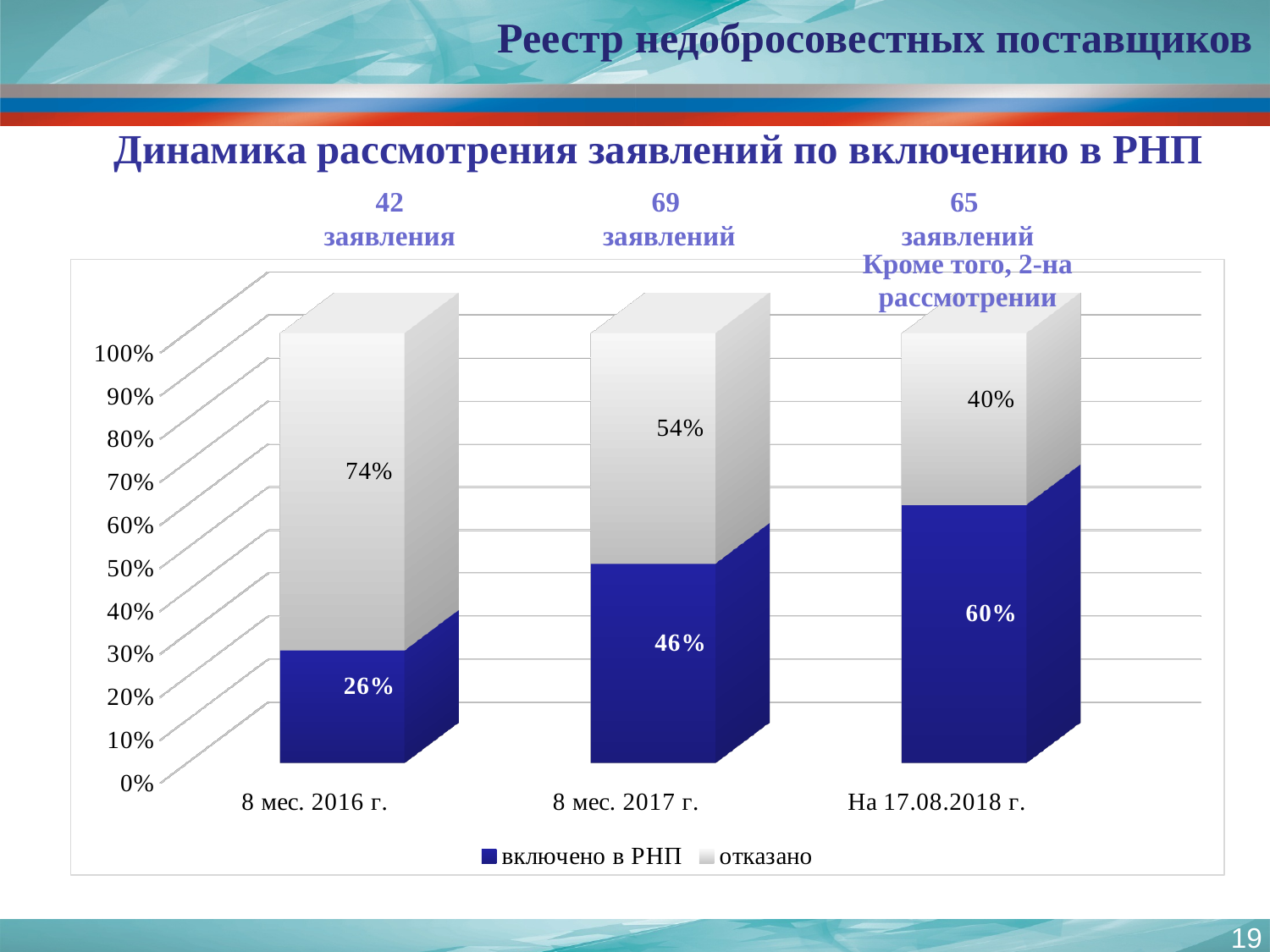
For 8 мес. 2017 г., which is larger: the share included in the RNP or the share refused? отказано (54%) What is the value of the отказано series for 8 мес. 2016 г.? 74% Which period has the highest share of applications included in the RNP (включено в РНП)? На 17.08.2018 г. What is the value of the включено в РНП series for На 17.08.2018 г.? 60% What kind of chart is shown on the slide? Stacked bar chart What percentage of applications was included in the RNP (включено в РНП) for 8 мес. 2016 г.? 26% How many periods (categories) are shown on the x axis? 3 Which period has the lowest share of refused applications (отказано)? На 17.08.2018 г. How many series does the legend list? 2 What percentage of applications was refused (отказано) for 8 мес. 2017 г.? 54% What is the difference between the отказано and включено в РНП shares for 8 мес. 2016 г.? 48% Does the share of applications included in the RNP rise or fall from 8 мес. 2016 г. to На 17.08.2018 г.? Rises